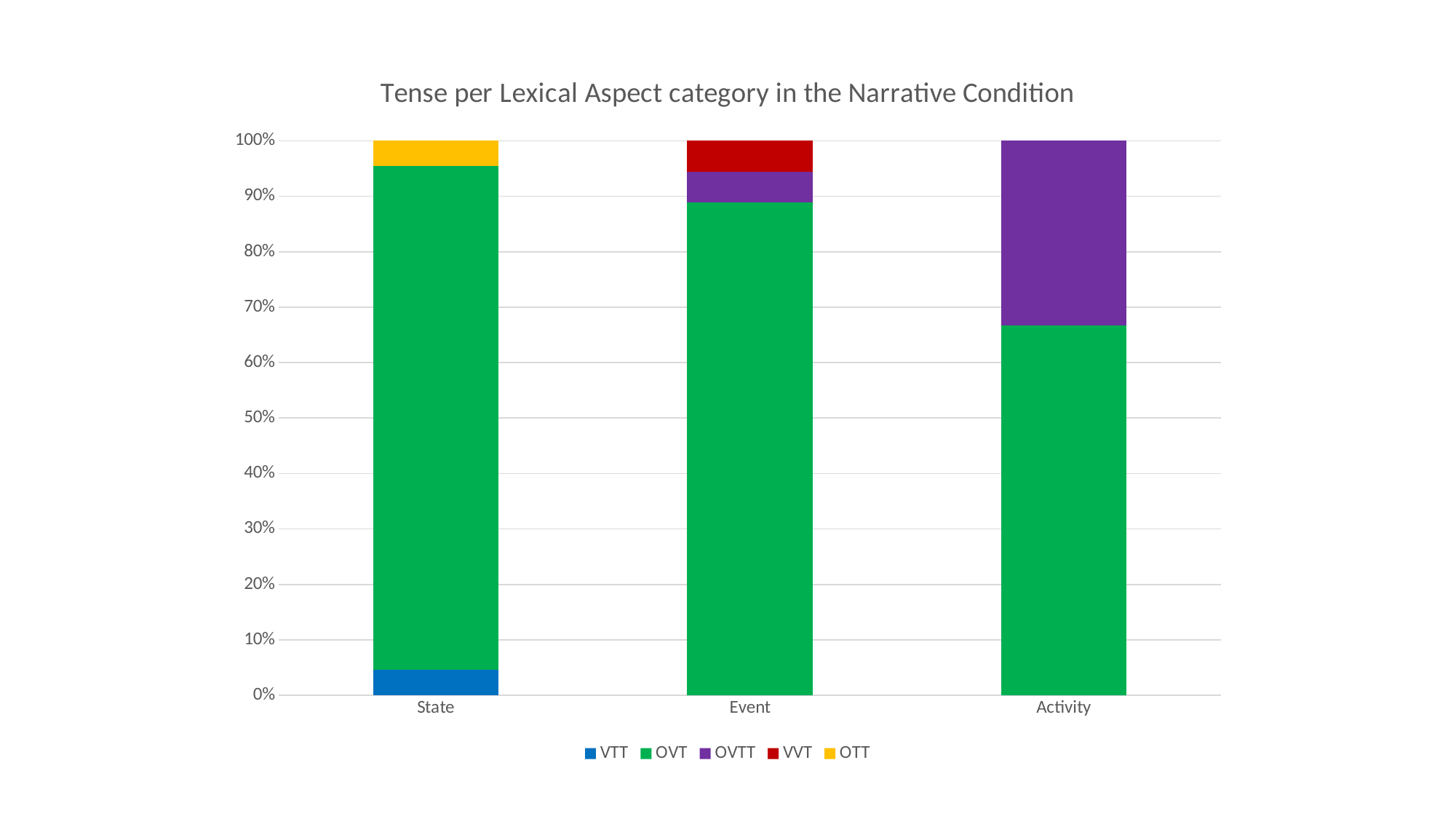
Which category has the smallest OVT share? Activity How many lexical aspect categories are shown on the x axis? 3 Is the OVT share for State greater or less than 80%? greater Is the OVT share for Activity greater or less than 70%? less What kind of chart is shown on the slide? Stacked bar chart Is the VTT share for State greater or less than 10%? less Which category is the only one that includes the VVT series? Event In the Activity bar, which is larger, the OVT share or the OVTT share? OVT How many series does the legend list? 5 Which category has the largest OVTT share? Activity